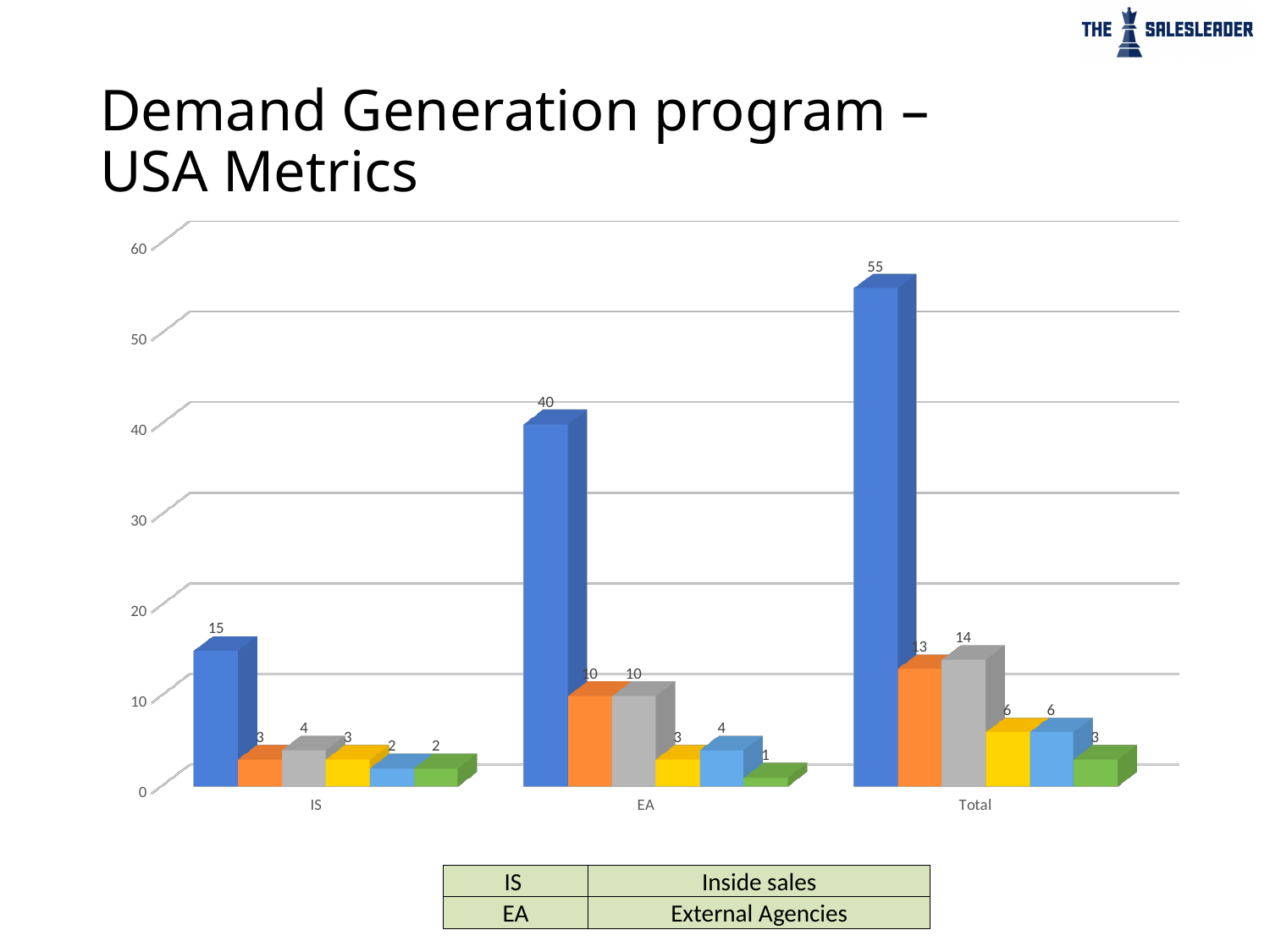
According to the table below the chart, what does EA stand for? External Agencies What kind of chart is shown on the slide? Bar chart What is the value of the blue bar for the Total category? 55 Which category has the lowest blue bar? IS Which is larger, the blue bar for EA or the blue bar for IS? EA What is the value of the blue bar for the EA category? 40 What is the value of the blue bar for the IS category? 15 How many categories are shown on the x axis? 3 Which category has the highest blue bar? Total What is the value of the gray bar for the Total category? 14 What is the difference between the blue bar values for EA and IS? 25 What is the value of the orange bar for the EA category? 10